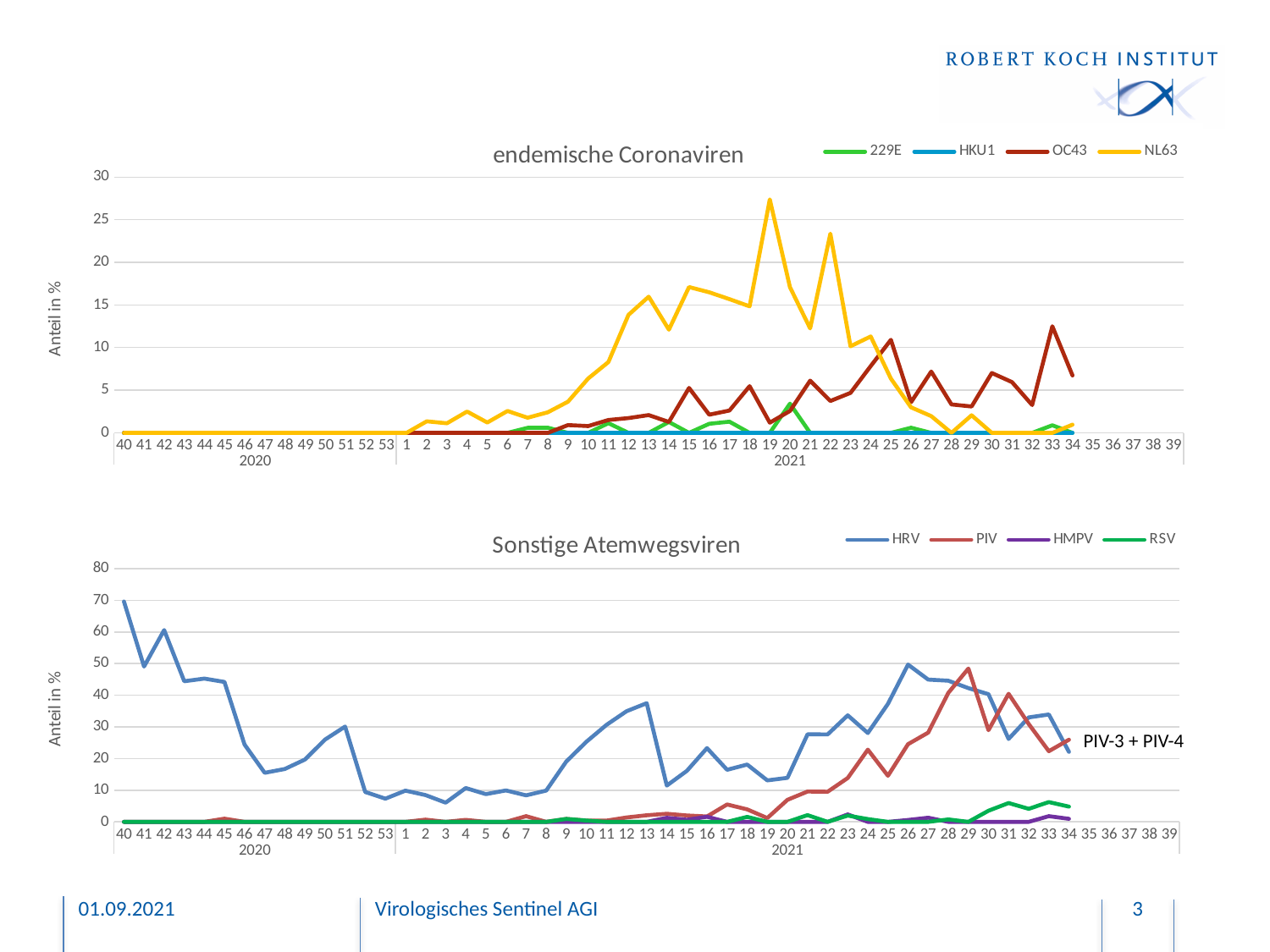
In the 'endemische Coronaviren' chart, is the value for OC43 in week 33 of 2021 greater or less than 10? greater What kind of chart is the 'Sonstige Atemwegsviren' chart? line chart In the 'Sonstige Atemwegsviren' chart, is the value for HRV in week 40 of 2020 greater or less than 60? greater In the 'Sonstige Atemwegsviren' chart, which series reaches the highest value overall? HRV In the 'Sonstige Atemwegsviren' chart, is the value for PIV in week 29 of 2021 greater or less than 40? greater In the 'Sonstige Atemwegsviren' chart, does the HRV line rise or fall from week 40 to week 47 of 2020? fall In the 'endemische Coronaviren' chart, which series reaches the highest value? NL63 How many series does the legend of the 'endemische Coronaviren' chart list? 4 What kind of chart is the 'endemische Coronaviren' chart? line chart What annotation text is printed next to the end of the PIV line in the 'Sonstige Atemwegsviren' chart? PIV-3 + PIV-4 How many series does the legend of the 'Sonstige Atemwegsviren' chart list? 4